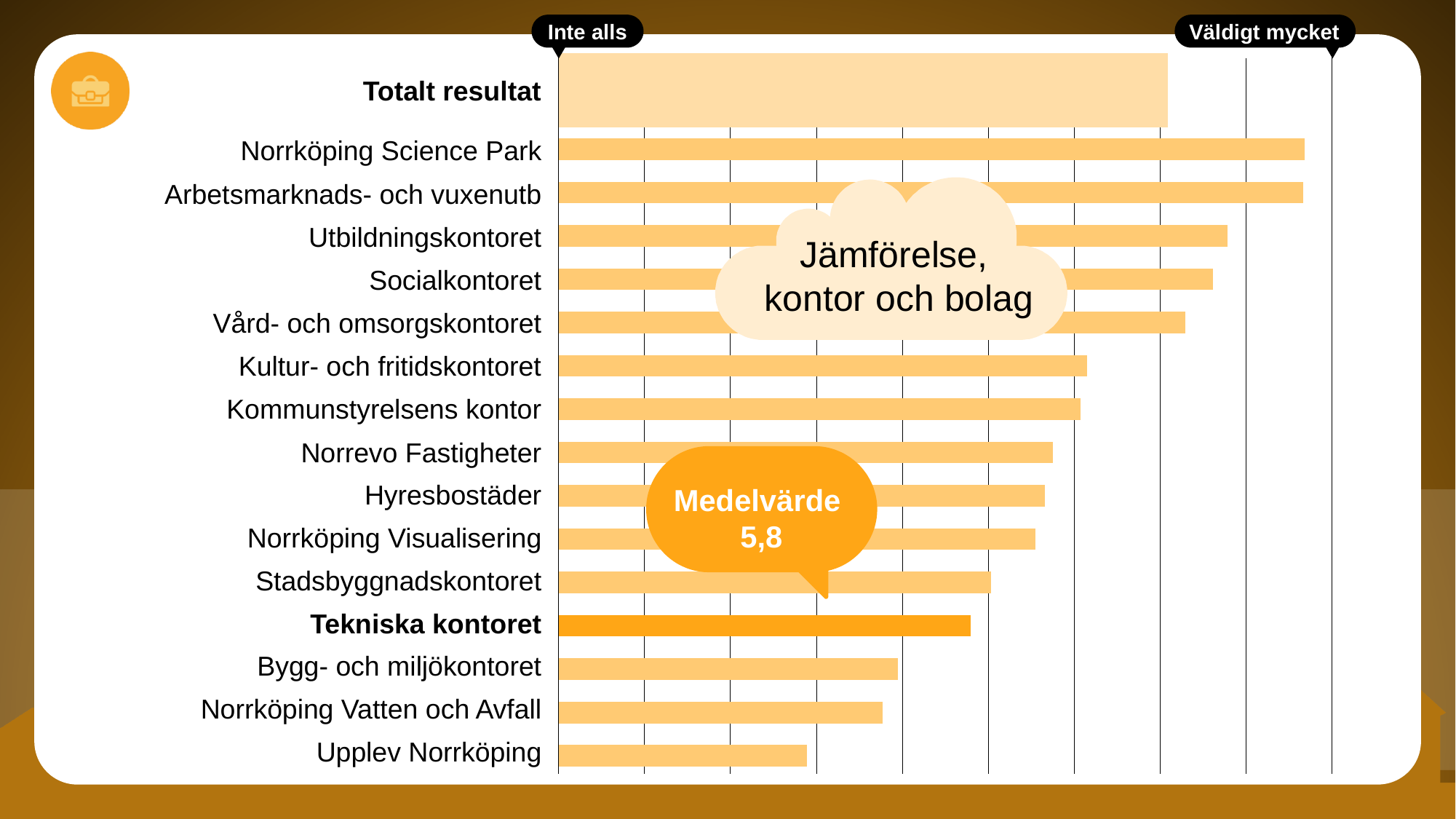
Which bar is highlighted in a darker orange colour? Tekniska kontoret Which has the longer bar, Socialkontoret or Bygg- och miljökontoret? Socialkontoret How many organisations (excluding Totalt resultat) are listed in the chart? 15 Which has the longer bar, Norrköping Vatten och Avfall or Upplev Norrköping? Norrköping Vatten och Avfall Which has the longer bar, Norrköping Science Park or Stadsbyggnadskontoret? Norrköping Science Park Do the bars get shorter or longer going from the top organisation to the bottom one? Shorter Which organisation has the shortest bar in the chart? Upplev Norrköping What is the title shown in the cloud on the chart? Jämförelse, kontor och bolag What kind of chart is shown on the slide? Bar chart What mean value (Medelvärde) is shown in the speech bubble? 5,8